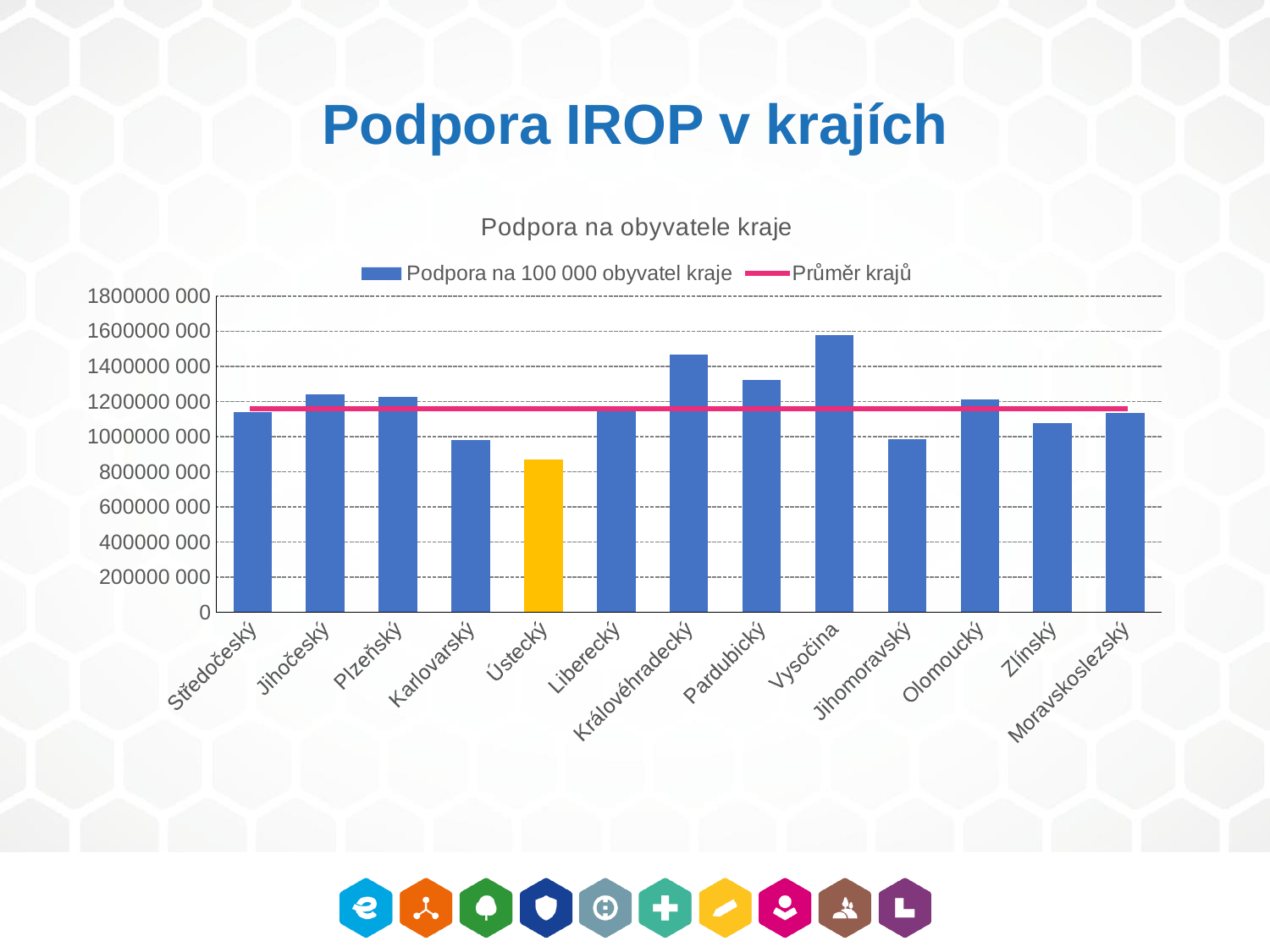
How many regions (categories) are shown on the x axis of the chart? 13 Which region has a larger value, Pardubický or Jihočeský? Pardubický Is the value for Ústecký greater or less than 1000000 000? less What kind of chart is shown on the slide? combination bar and line chart Is the value for Vysočina greater or less than 1400000 000? greater Which region has a larger value, Karlovarský or Ústecký? Karlovarský Is the value for Královéhradecký greater or less than 1400000 000? greater Which region's bar is highlighted in yellow instead of blue? Ústecký Which region has the highest value for Podpora na 100 000 obyvatel kraje? Vysočina How many series does the chart legend list? 2 Which region has the lowest value for Podpora na 100 000 obyvatel kraje? Ústecký